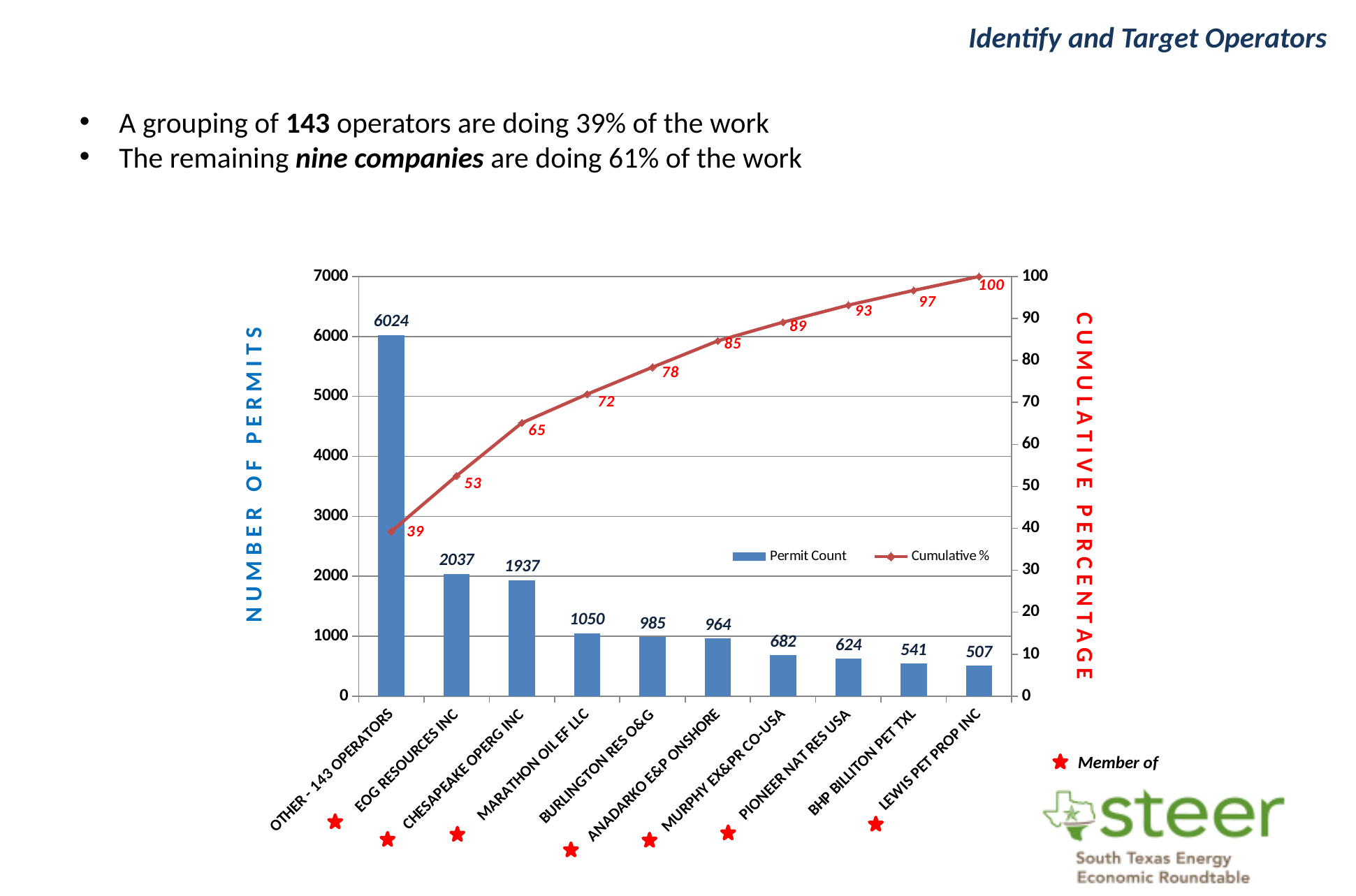
Which has a larger Permit Count, BURLINGTON RES O&G or ANADARKO E&P ONSHORE? BURLINGTON RES O&G What is the label of the left vertical axis? NUMBER OF PERMITS What is the Cumulative % value at PIONEER NAT RES USA? 93 Does the Cumulative % line rise or fall from left to right? rise How many series does the legend list? 2 What is the Permit Count for EOG RESOURCES INC? 2037 How many categories are shown on the x axis? 10 What is the Cumulative % value at CHESAPEAKE OPERG INC? 65 What is the difference in Permit Count between EOG RESOURCES INC and CHESAPEAKE OPERG INC? 100 What is the Permit Count for MARATHON OIL EF LLC? 1050 Which category has the highest Permit Count? OTHER - 143 OPERATORS Which category has the lowest Permit Count? LEWIS PET PROP INC